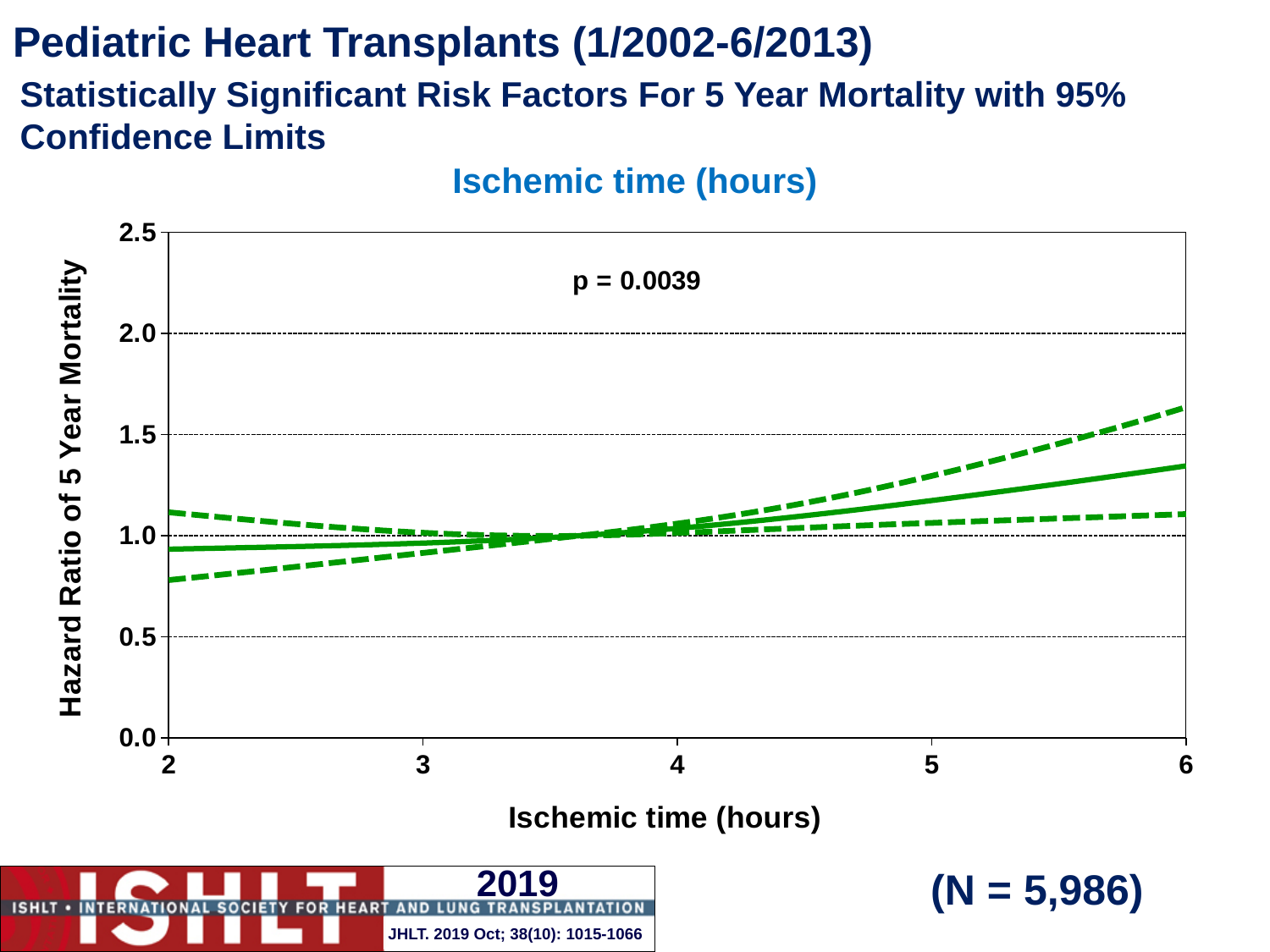
What is the label of the x axis of the chart? Ischemic time (hours) Does the solid hazard ratio line rise or fall as ischemic time increases from 2 to 6 hours? rise Is the hazard ratio on the solid line at 6 hours of ischemic time greater or less than 1.0? greater Is the upper dashed confidence limit at 2 hours of ischemic time greater or less than 1.0? greater Is the lower dashed confidence limit at 2 hours of ischemic time greater or less than 1.0? less What p-value is printed on the chart? p = 0.0039 What kind of chart is shown on the slide? line chart How many lines are plotted on the chart? 3